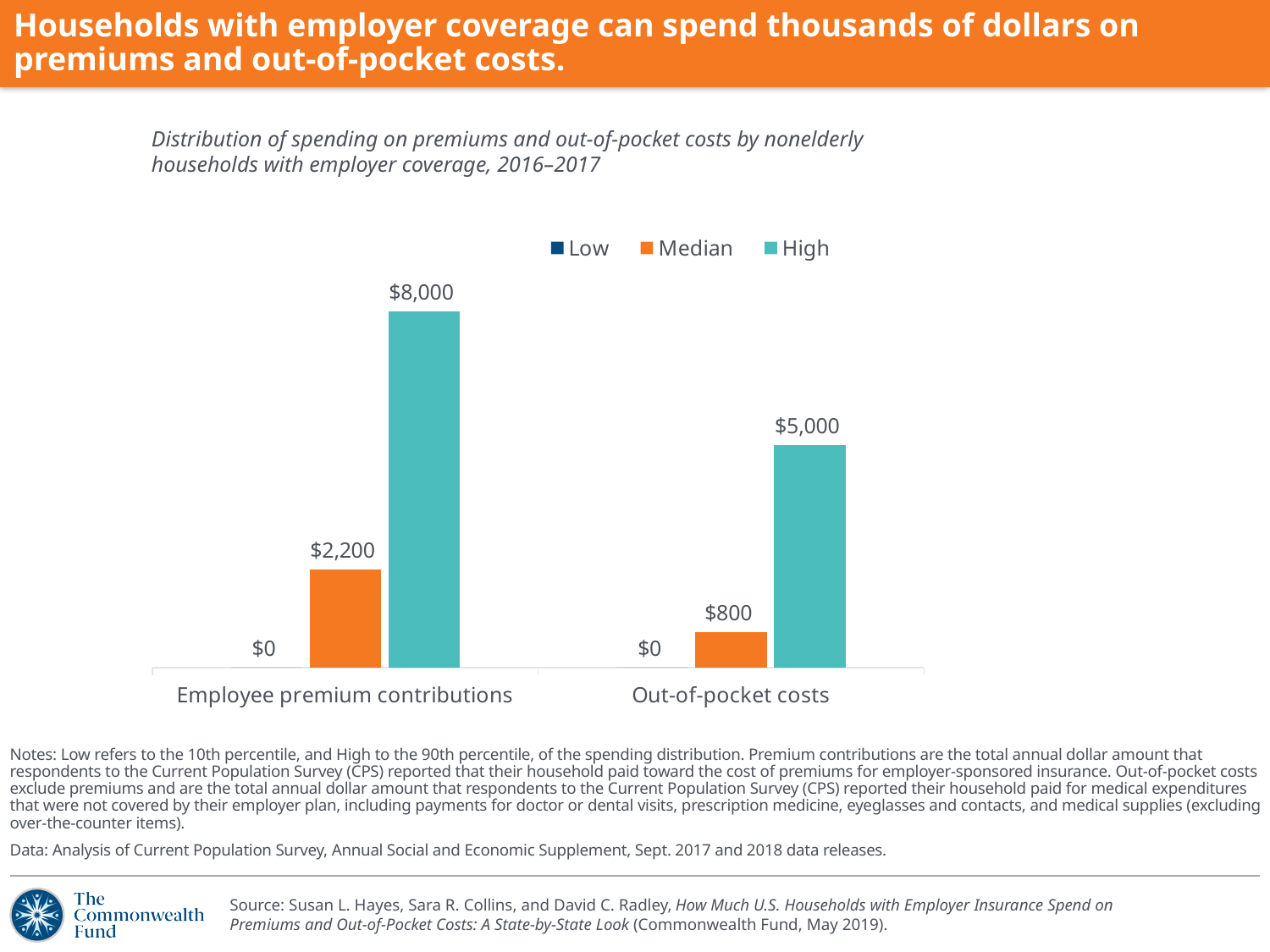
How many series does the legend list? 3 What is the difference between the Median and High values for Out-of-pocket costs? $4,200 Which category has the higher High value? Employee premium contributions What is the High value for Employee premium contributions? $8,000 What is the Low value for Out-of-pocket costs? $0 What is the Median value for Employee premium contributions? $2,200 What kind of chart is shown on the slide? bar chart What is the Median value for Out-of-pocket costs? $800 What is the difference between the High values for Employee premium contributions and Out-of-pocket costs? $3,000 Is the Median value for Employee premium contributions larger or smaller than the Median value for Out-of-pocket costs? larger Which series is shown in orange in the legend? Median How many categories are shown on the x axis? 2